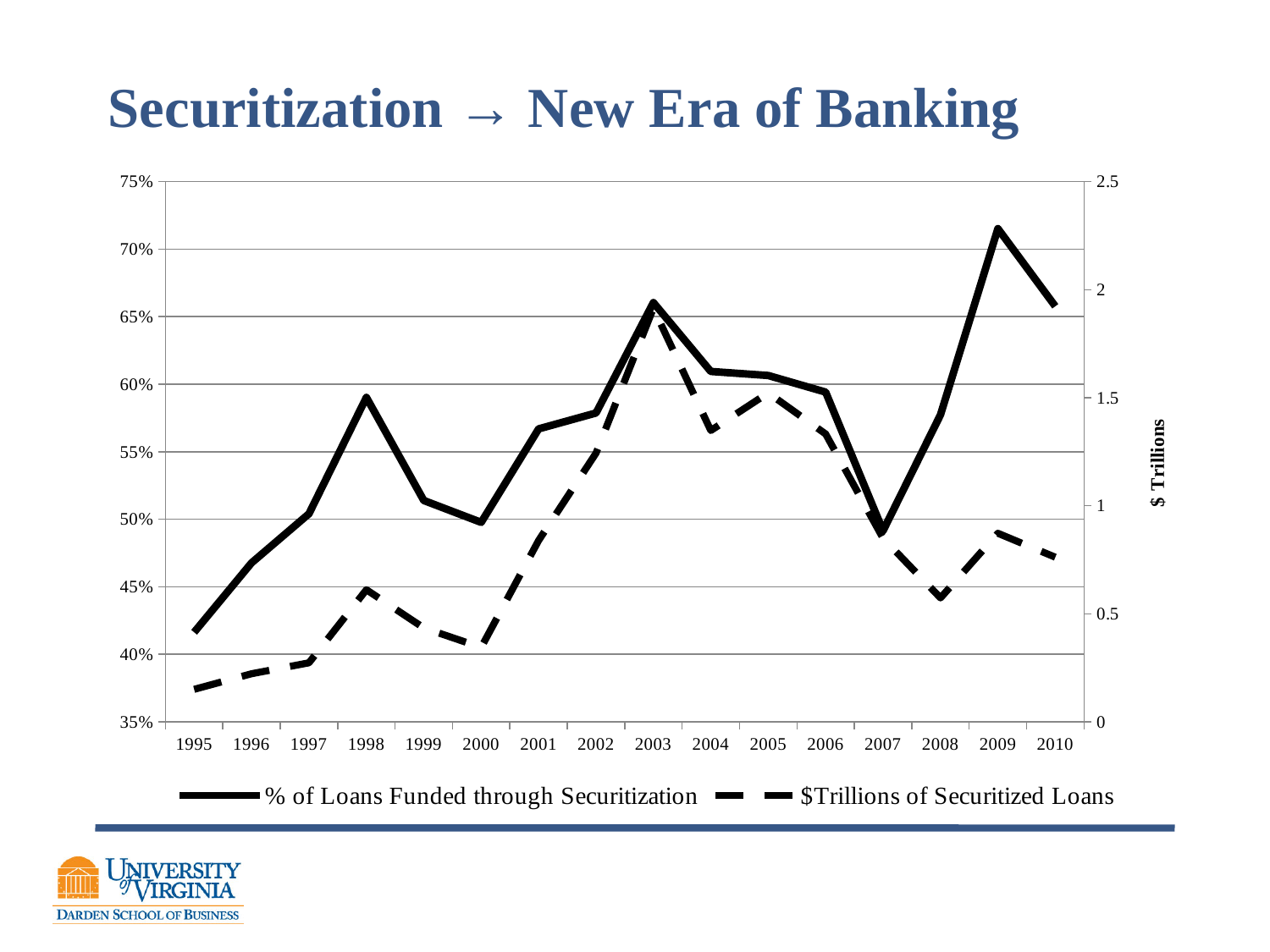
Is the % of Loans Funded through Securitization in 2007 greater or less than 50%? less In which year is the % of Loans Funded through Securitization highest? 2009 What is the title of the right-hand vertical axis? $ Trillions How many series does the legend list? 2 Is the value of $Trillions of Securitized Loans in 2003 greater or less than 1.5? greater In which year is the % of Loans Funded through Securitization lowest? 1995 Which year has a higher % of Loans Funded through Securitization, 1998 or 1999? 1998 What kind of chart is shown on the slide? line chart Is the % of Loans Funded through Securitization in 2009 greater or less than 70%? greater In which year is $Trillions of Securitized Loans highest? 2003 Does the % of Loans Funded through Securitization rise or fall from 2007 to 2009? rise How many years are plotted along the x axis? 16